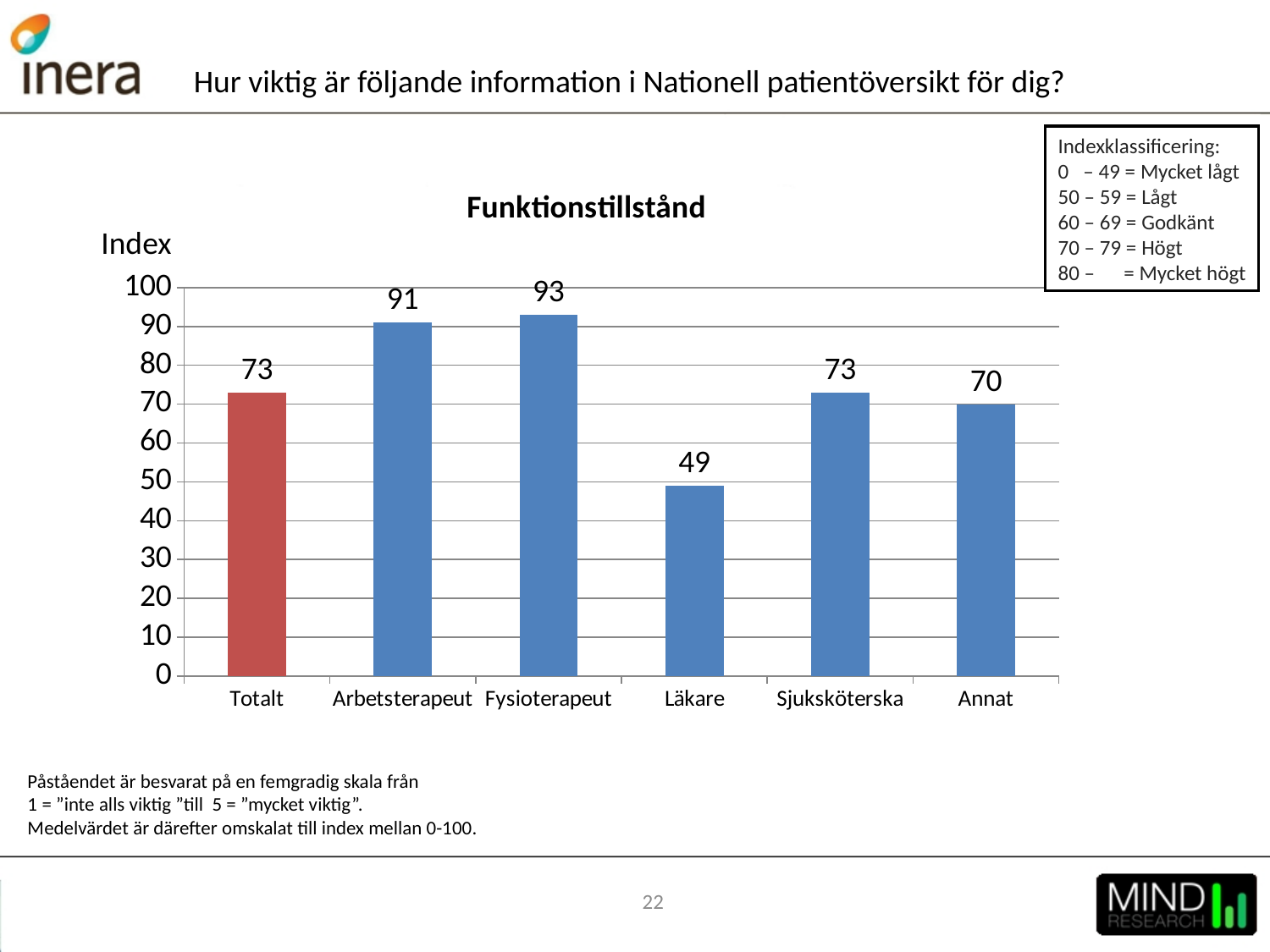
What is the index value for Läkare? 49 What is the index value for Totalt? 73 Which has a higher index value, Sjuksköterska or Annat? Sjuksköterska How many categories are shown on the x axis? 6 What is the index value for Fysioterapeut? 93 What is the title of the chart? Funktionstillstånd Which category has the highest index value? Fysioterapeut What is the difference between the index values for Arbetsterapeut and Läkare? 42 What kind of chart is shown on the slide? Bar chart Is the value for Läkare greater or less than 50? less Which category has the lowest index value? Läkare What is the index value for Annat? 70